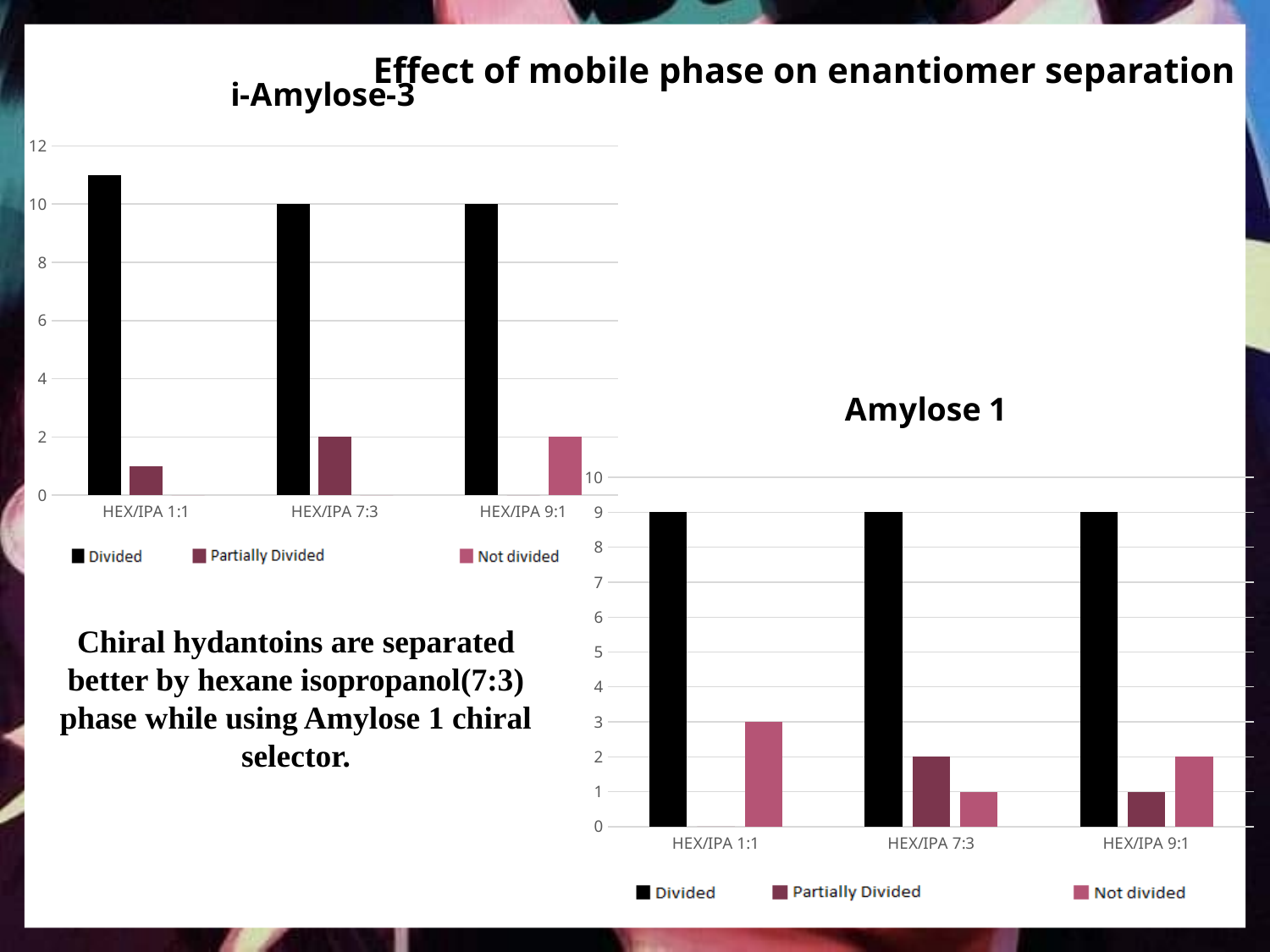
In the Amylose 1 chart, what is the value of the Not divided series for HEX/IPA 1:1? 3 In the i-Amylose-3 chart, which mobile phase has the highest Divided value? HEX/IPA 1:1 In the i-Amylose-3 chart, what is the value of the Divided series for HEX/IPA 7:3? 10 In the Amylose 1 chart, what is the difference between the Not divided values for HEX/IPA 1:1 and HEX/IPA 7:3? 2 How many mobile phase categories are shown on the x axis of the i-Amylose-3 chart? 3 How many series does the legend of the Amylose 1 chart list? 3 In the i-Amylose-3 chart, what is the value of the Not divided series for HEX/IPA 9:1? 2 In the Amylose 1 chart, what is the value of the Partially Divided series for HEX/IPA 9:1? 1 What type of chart is the Amylose 1 chart? Bar chart In the Amylose 1 chart, what is the value of the Divided series for HEX/IPA 7:3? 9 In the Amylose 1 chart, which is larger for HEX/IPA 7:3: Partially Divided or Not divided? Partially Divided In the i-Amylose-3 chart, is the Divided value for HEX/IPA 1:1 greater or less than 10? greater